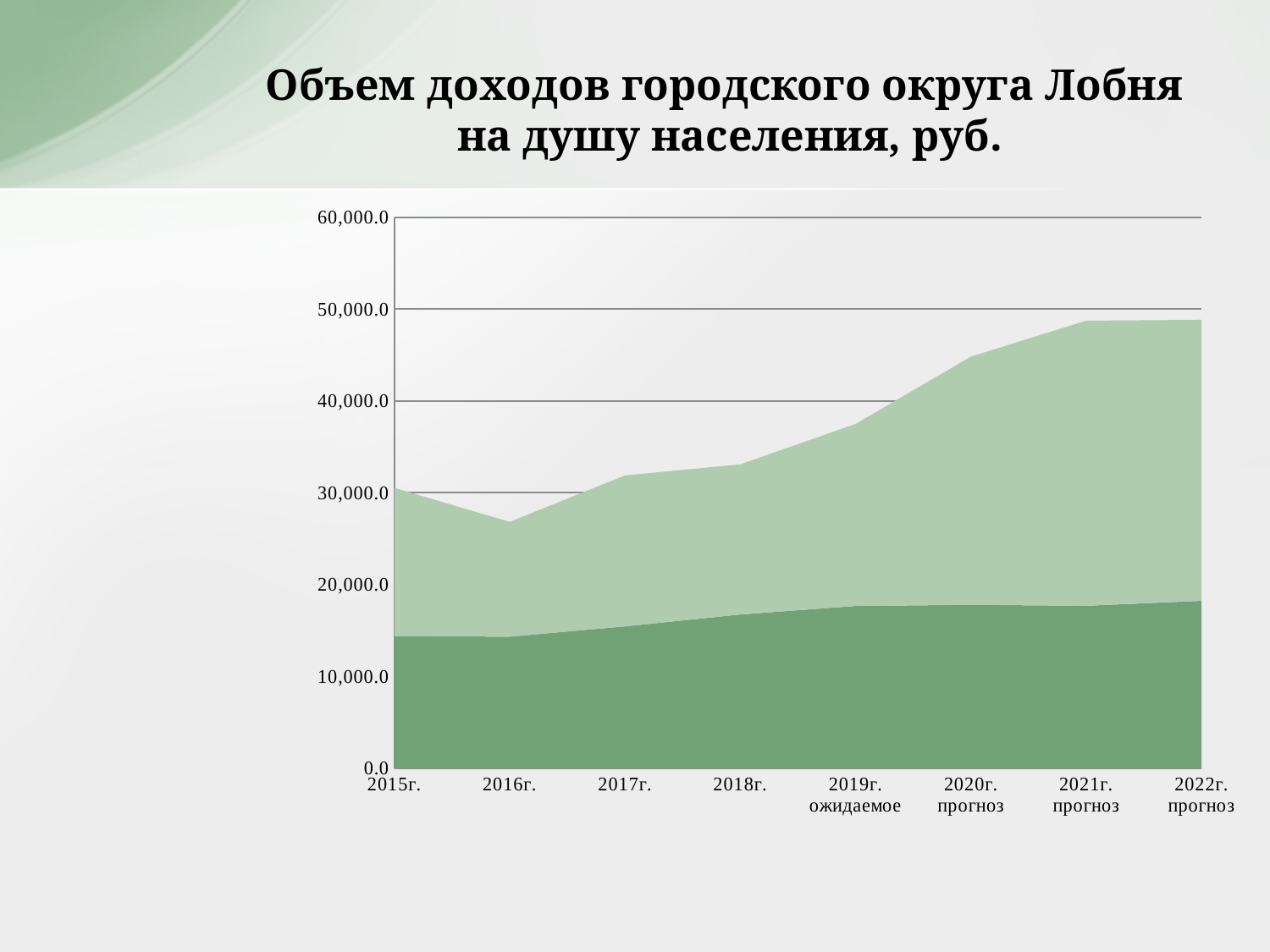
In which year is the top of the stacked area lowest? 2016г. Which is larger: the total for 2017г. or the total for 2016г.? 2017г. Is the total (top of the stacked area) for 2021г. прогноз greater or less than 50,000.0? less Is the total (top of the stacked area) for 2016г. greater or less than 30,000.0? less Is the total (top of the stacked area) for 2020г. прогноз greater or less than 40,000.0? greater How many years (categories) are shown along the x axis? 8 Does the total (top of the stacked area) generally rise or fall from 2016г. to 2021г. прогноз? rise How many shaded areas (series) are stacked in the chart? 2 What kind of chart is shown on the slide? Area chart What is the title of the chart? Объем доходов городского округа Лобня на душу населения, руб.